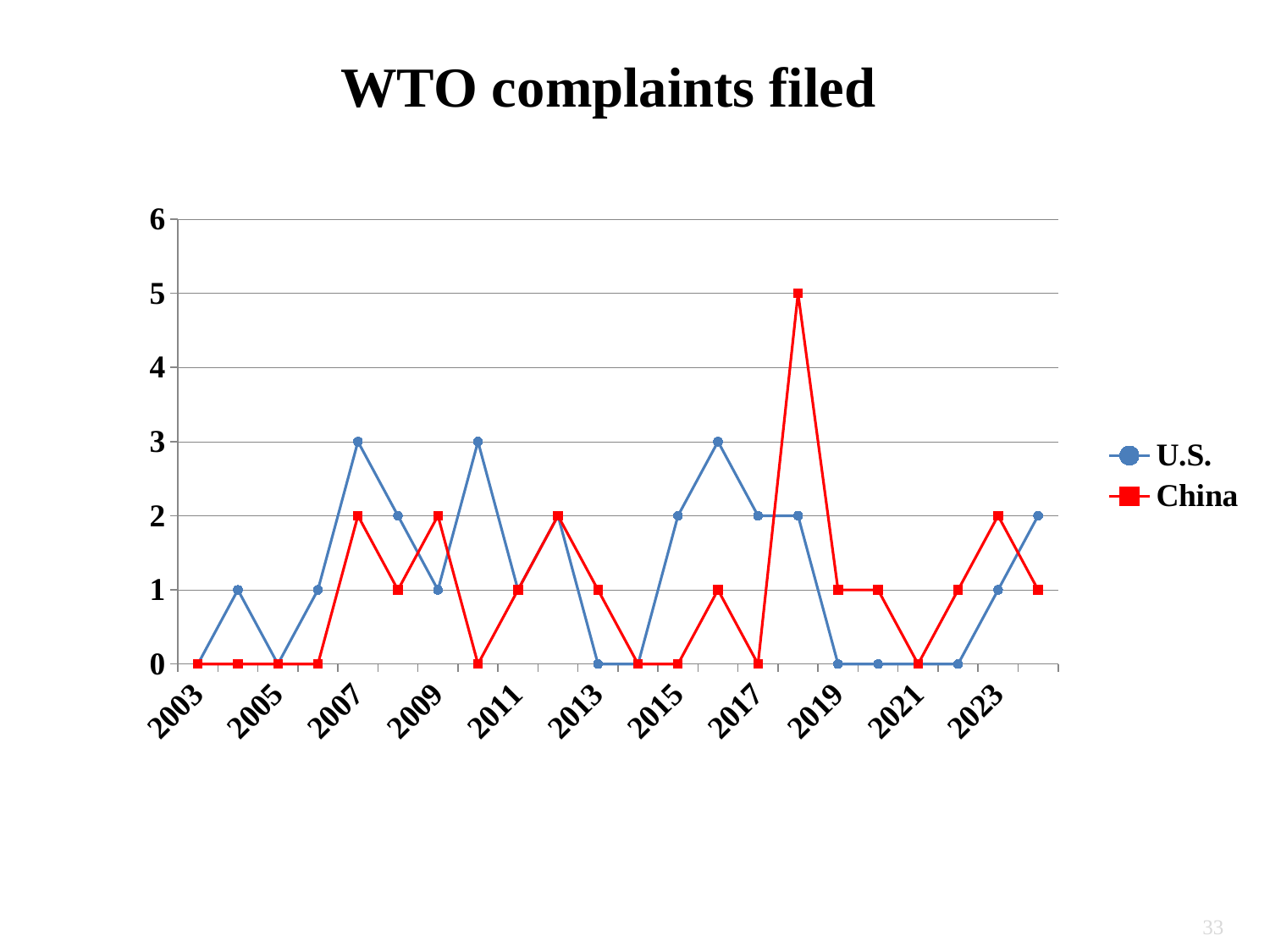
What is the highest value reached by the China series? 5 How many WTO complaints did China file in 2007? 2 What kind of chart is shown on the slide? line chart What is the title of the chart? WTO complaints filed What is the value for China in 2009? 2 What is the value for China in 2003? 0 How many WTO complaints did the U.S. file in 2007? 3 What is the value for the U.S. in 2011? 1 What is the difference between the U.S. and China values in 2007? 1 How many series does the legend list? 2 What is the value for the U.S. in 2023? 1 In 2015, which series has the larger value, U.S. or China? U.S.